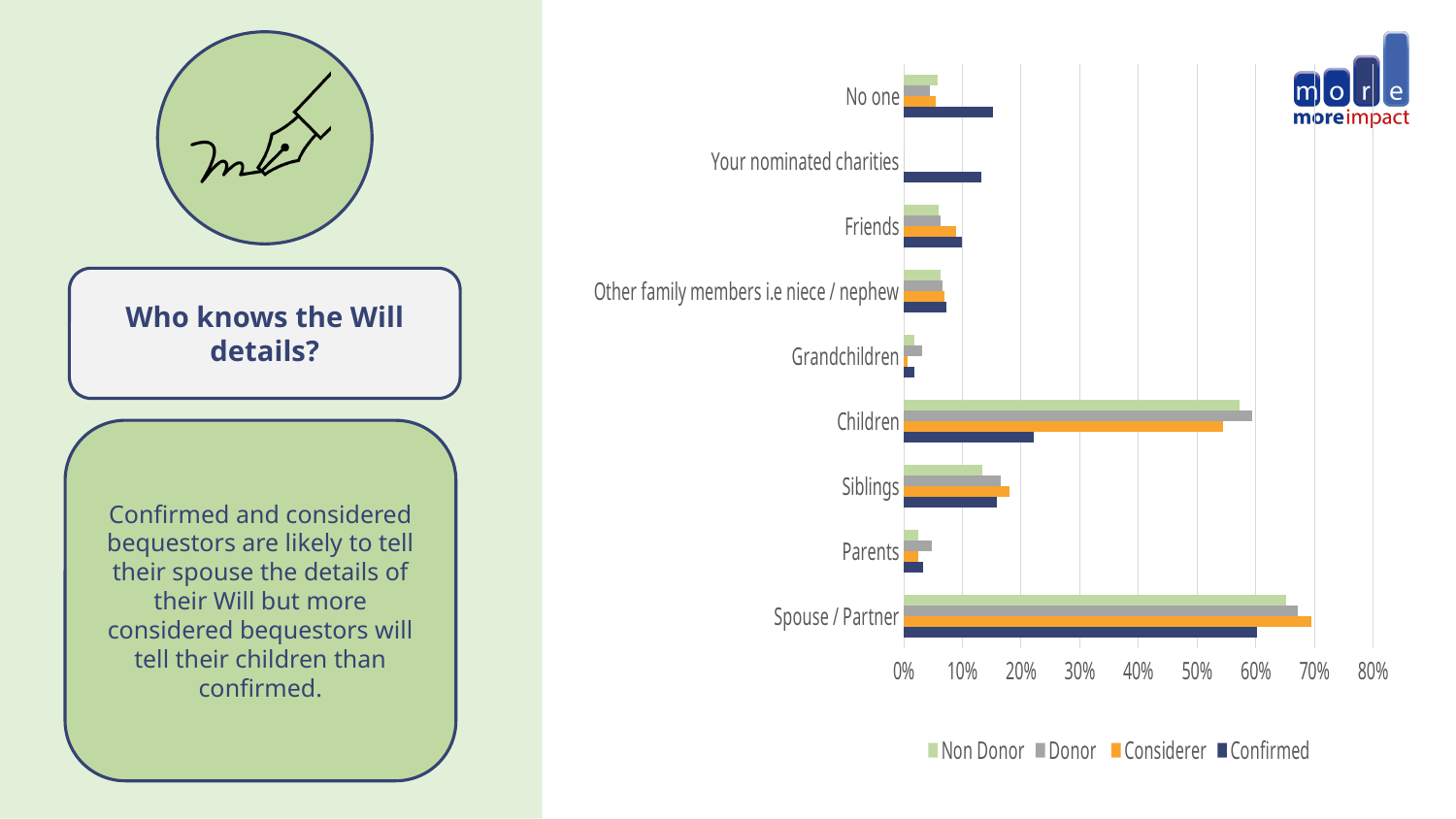
For Spouse / Partner, which is larger: the Considerer value or the Confirmed value? Considerer Is the Non Donor value for Children greater or less than 50%? greater Is the Confirmed value for Children greater or less than 30%? less Is the Confirmed value for No one greater or less than 10%? greater What kind of chart is shown on the slide? bar chart Which series is shown in orange in the legend? Considerer Which category has the highest value for the Non Donor series? Spouse / Partner How many categories are plotted on the chart? 9 For Children, which is larger: the Non Donor value or the Confirmed value? Non Donor Which category has the highest value for the Confirmed series? Spouse / Partner How many series does the legend list? 4